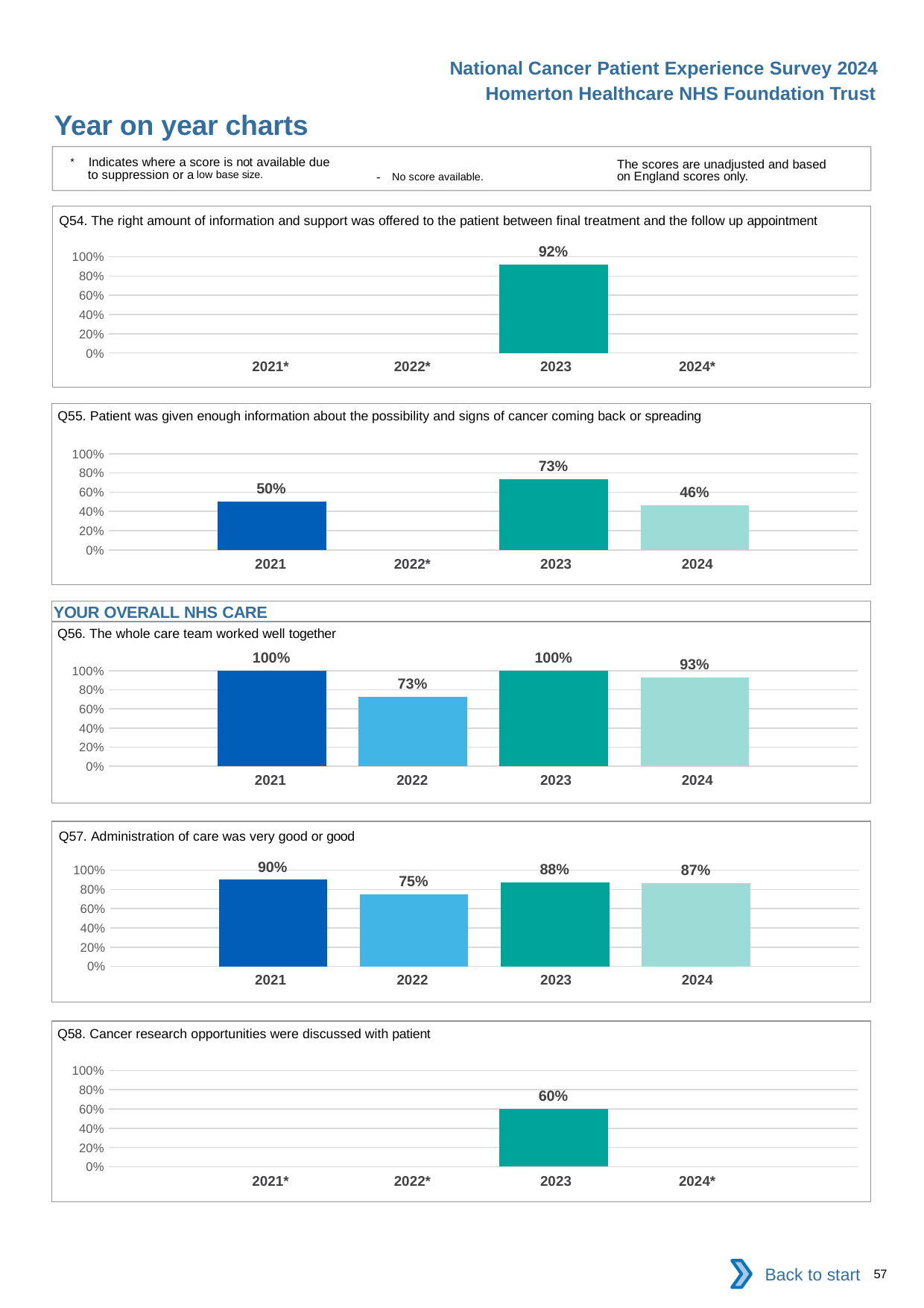
In the Q55 chart, what is the difference between the 2023 and 2021 values? 23% In the Q57 chart, which is larger, the value for 2021 or the value for 2022? 2021 In the Q56 chart, which year has the lowest value? 2022 In the Q57 chart, what is the difference between the 2021 and 2024 values? 3% In the Q56 chart, what is the value for 2022? 73% In the Q55 chart, what is the value for 2024? 46% In the Q58 chart, is the value for 2023 greater or less than 40%? greater How many years are shown on the x axis of the Q57 chart? 4 What type of chart is the Q56 chart? Bar chart In the Q54 chart, what is the value for 2023? 92% In the Q55 chart, which year has the highest value? 2023 In the Q58 chart, what is the value for 2023? 60%